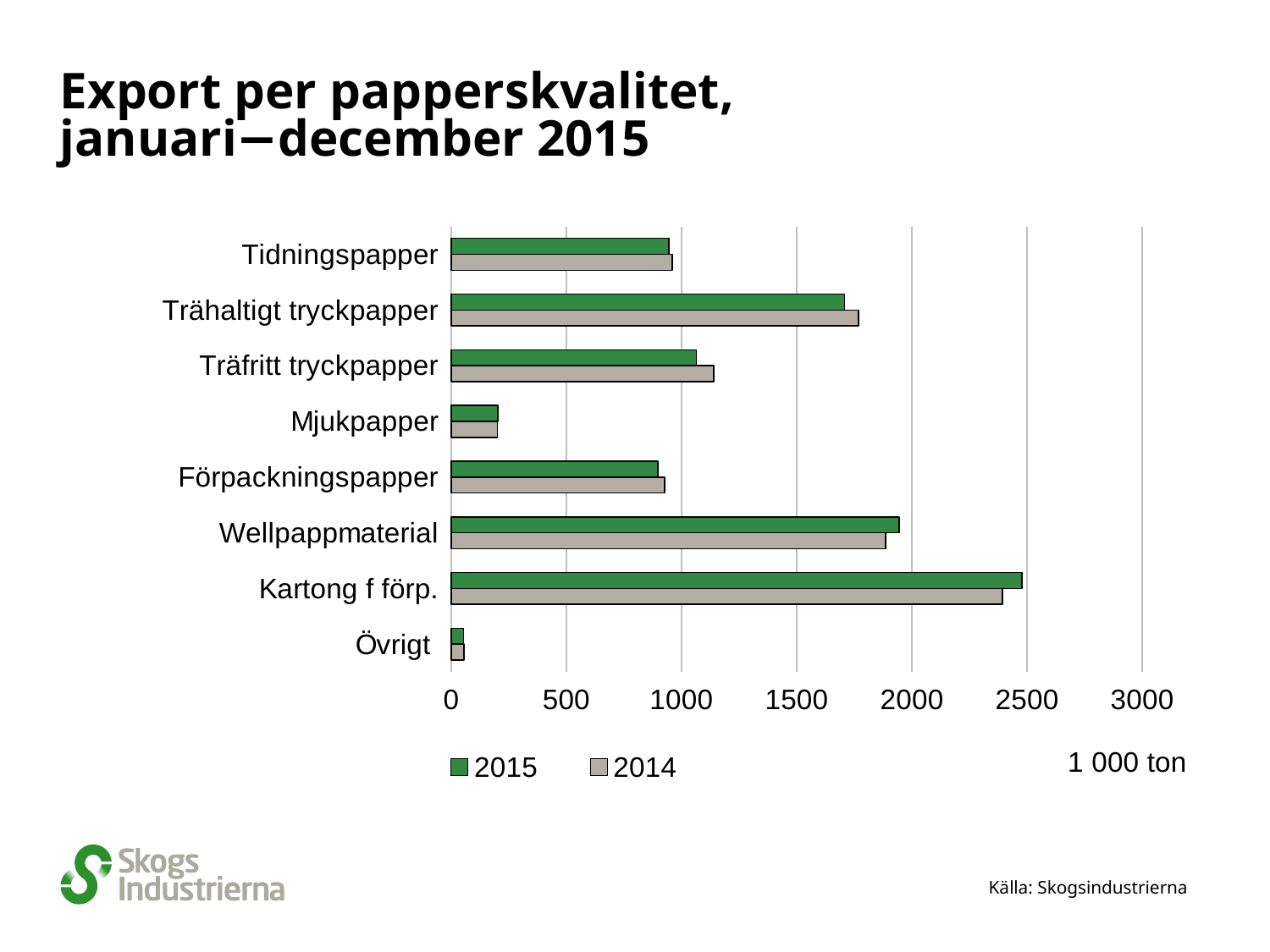
What kind of chart is shown on the slide? bar chart Which category has the highest export value for 2015? Kartong f förp. How many paper categories are shown on the chart? 8 Is the 2015 value for Kartong f förp. greater or less than 2000? greater Is the 2014 value for Trähaltigt tryckpapper greater or less than 1500? greater For Träfritt tryckpapper, which year has the larger value, 2015 or 2014? 2014 Is the 2015 value for Wellpappmaterial greater or less than 2000? less For Kartong f förp., which year has the larger value, 2015 or 2014? 2015 How many series does the legend list? 2 What unit is stated for the values on the chart? 1 000 ton Which category has the lowest export value for 2015? Övrigt